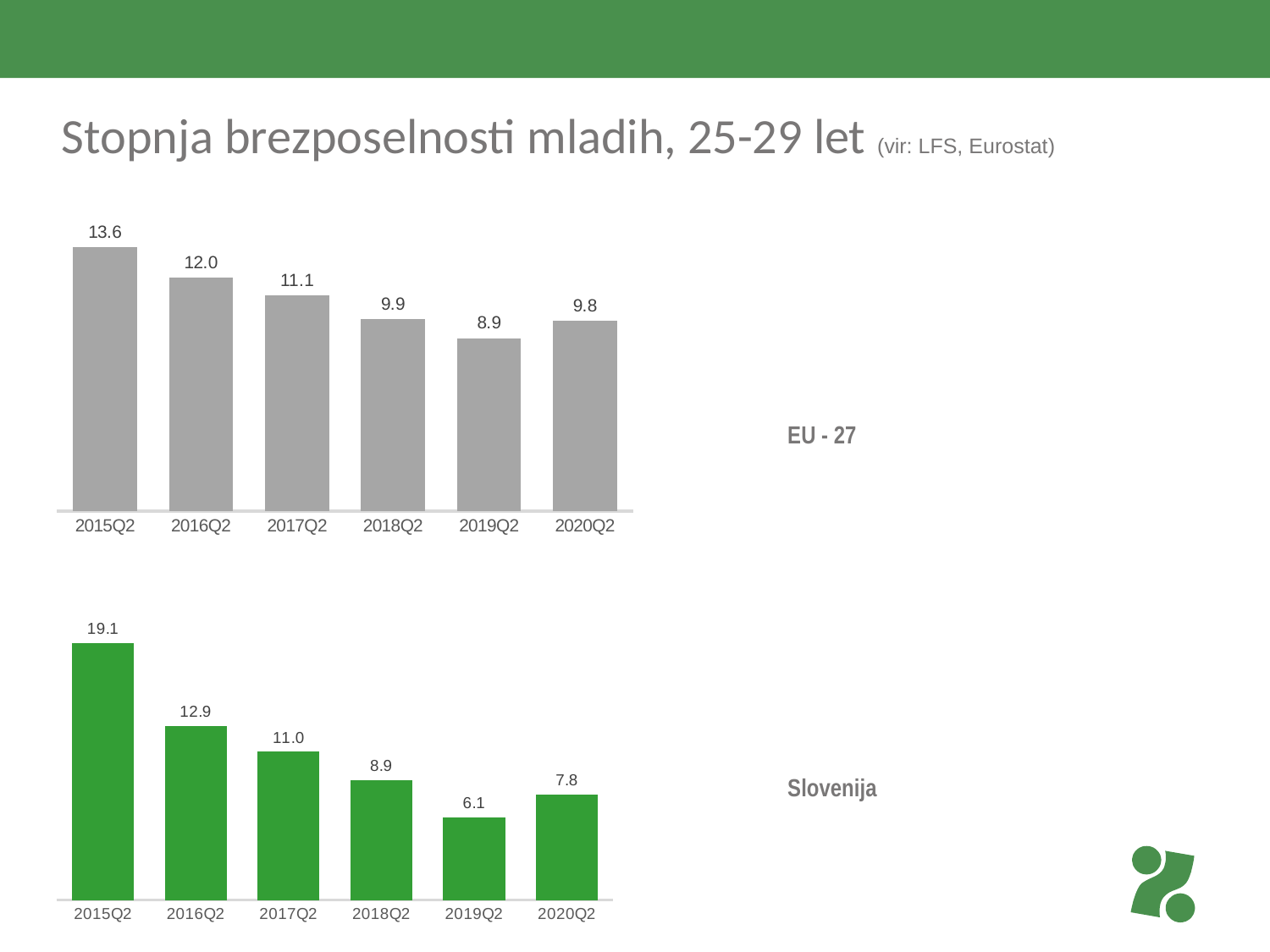
In the EU - 27 chart (top), which quarter has the lowest value? 2019Q2 In the EU - 27 chart (top), what is the difference between the 2015Q2 and 2020Q2 values? 3.8 In the Slovenija chart (bottom), what is the value for 2020Q2? 7.8 In the EU - 27 chart (top), do the values generally rise or fall from 2015Q2 to 2019Q2? Fall In the Slovenija chart (bottom), which quarter has the highest value? 2015Q2 What colour are the bars in the Slovenija chart (bottom)? Green In the Slovenija chart (bottom), what is the value for 2019Q2? 6.1 How many quarters are shown in the EU - 27 chart (top)? 6 In the Slovenija chart (bottom), what is the difference between the 2015Q2 and 2016Q2 values? 6.2 In the EU - 27 chart (top), what is the value for 2015Q2? 13.6 In the Slovenija chart (bottom), which is larger, the value for 2017Q2 or the value for 2018Q2? 2017Q2 What kind of chart is the Slovenija chart (bottom)? Bar chart